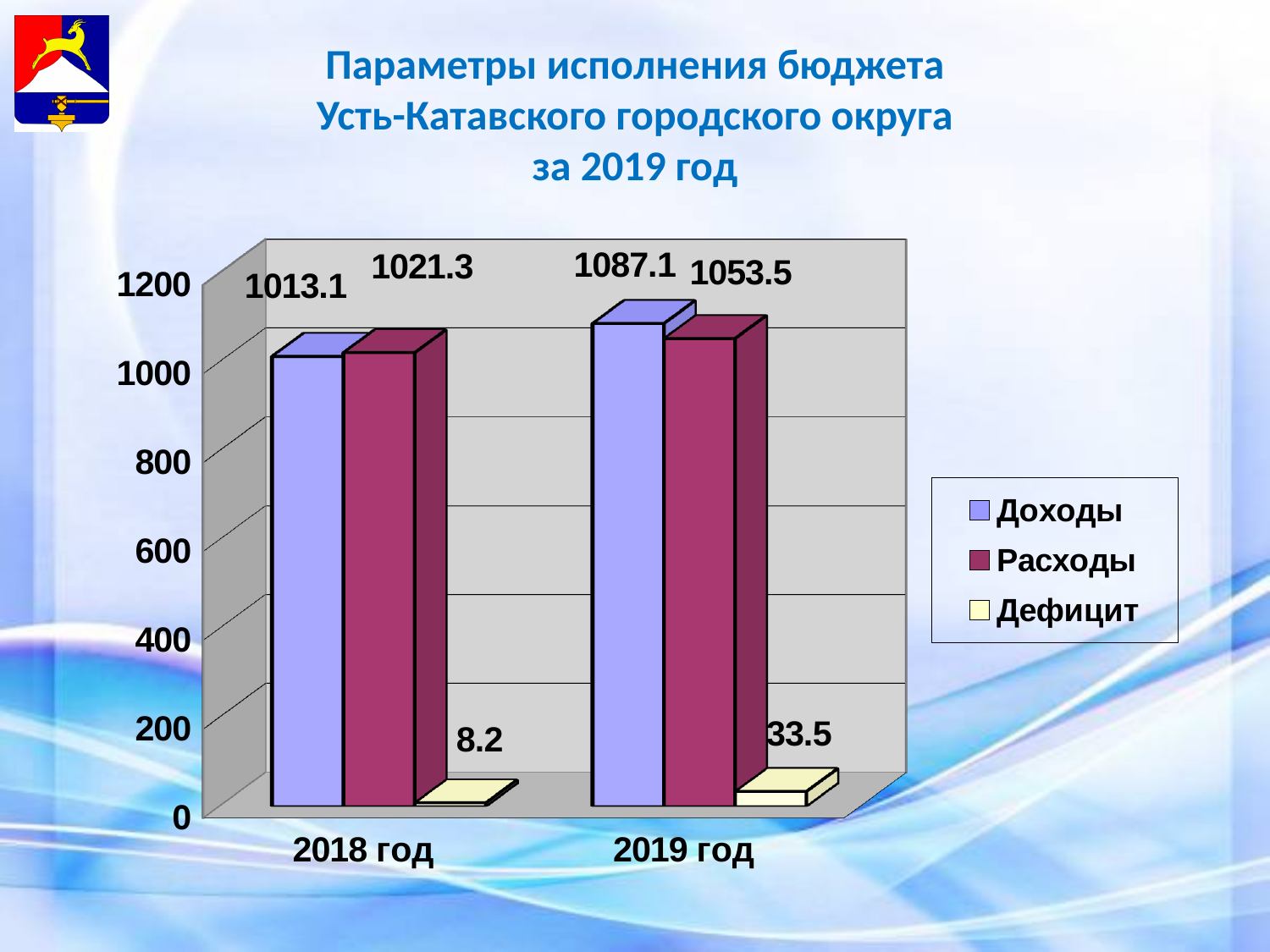
What is the difference between Расходы and Доходы in 2018 год? 8.2 What is the value of Доходы for 2018 год? 1013.1 What is the value of Дефицит for 2018 год? 8.2 What is the difference between Доходы in 2019 год and Доходы in 2018 год? 74.0 What kind of chart is shown on the slide? bar chart Which year has the higher value for Доходы? 2019 год Does the value of Дефицит rise or fall from 2018 год to 2019 год? rise What is the value of Дефицит for 2019 год? 33.5 How many series does the legend list? 3 How many categories are shown on the x axis? 2 Which series is shown in yellow in the legend? Дефицит What is the value of Расходы for 2019 год? 1053.5